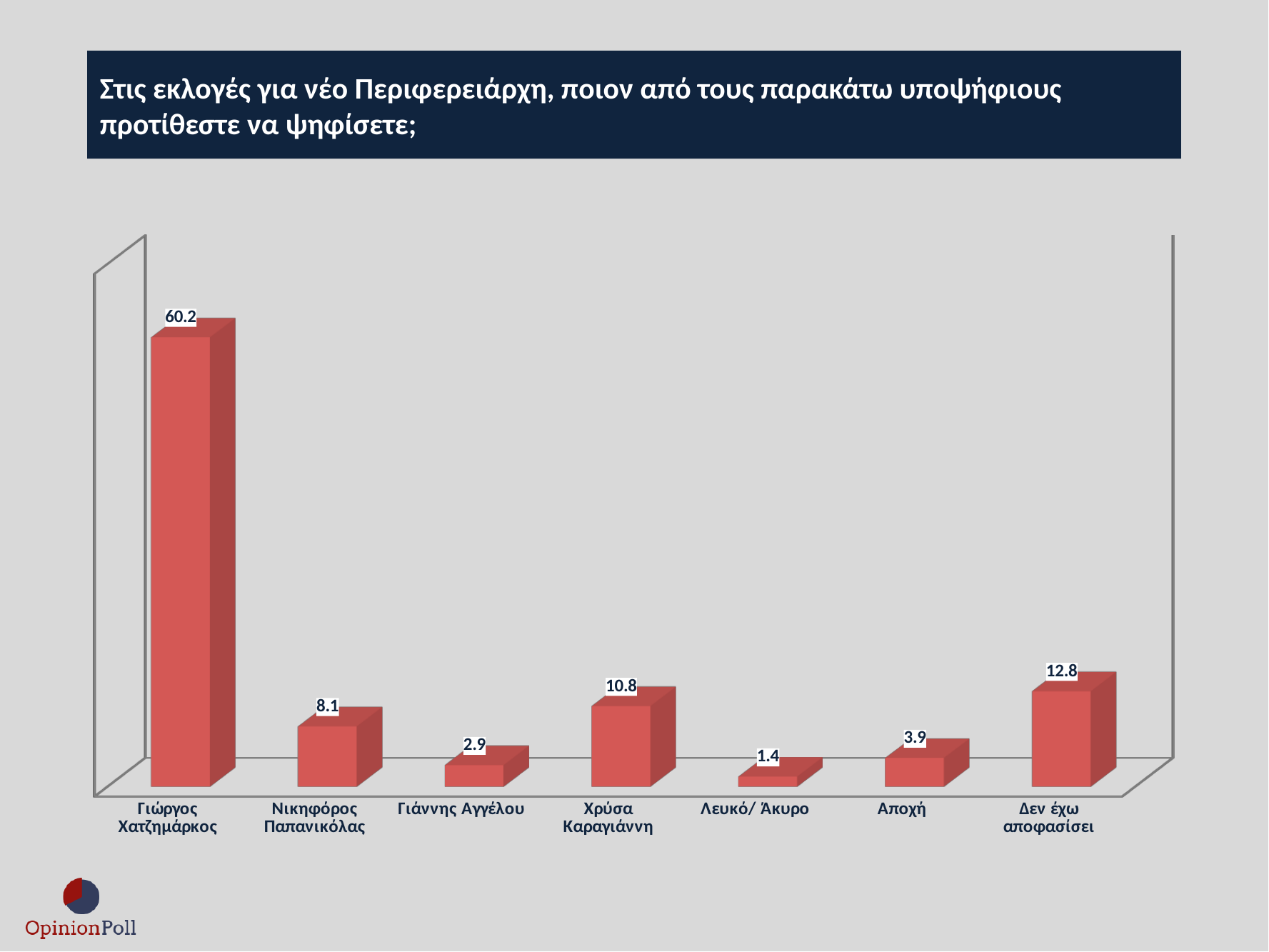
What is the value for Νικηφόρος Παπανικόλας? 8.1 Which category has the highest value? Γιώργος Χατζημάρκος How many categories are shown on the chart? 7 What is the value for Χρύσα Καραγιάννη? 10.8 What is the difference between the values for Δεν έχω αποφασίσει and Νικηφόρος Παπανικόλας? 4.7 What is the difference between the values for Γιώργος Χατζημάρκος and Χρύσα Καραγιάννη? 49.4 What is the value for Γιώργος Χατζημάρκος? 60.2 What colour are the bars in the chart? Red Which is larger, the value for Αποχή or the value for Γιάννης Αγγέλου? Αποχή What kind of chart is shown on the slide? Bar chart What is the value for Δεν έχω αποφασίσει? 12.8 Which category has the lowest value? Λευκό/ Άκυρο